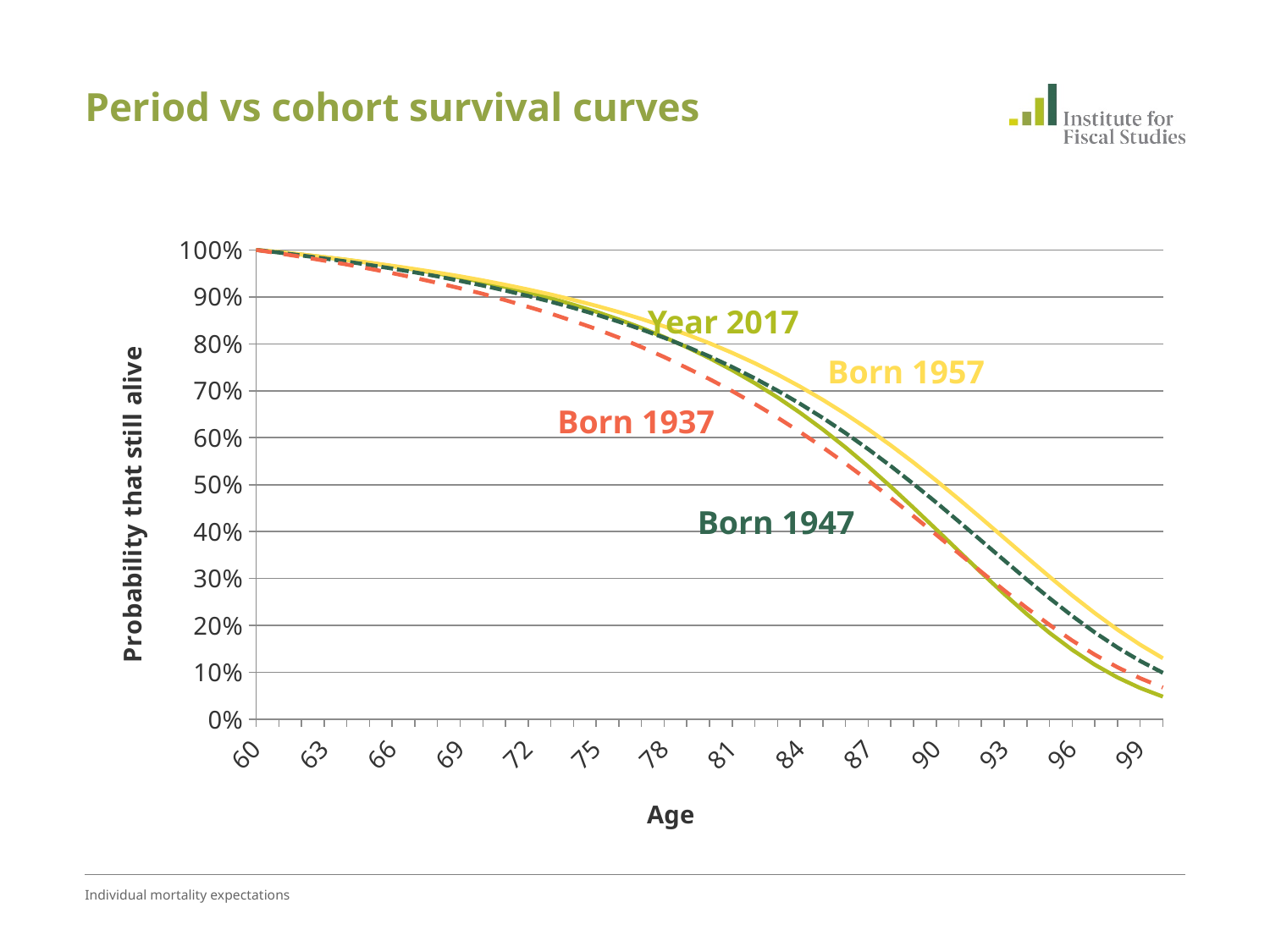
At age 84, which is larger: the Born 1957 curve or the Born 1937 curve? Born 1957 What is the label of the y axis? Probability that still alive Is the value of the Born 1957 curve at age 72 greater or less than 90%? greater What is the probability of still being alive at age 60 for the Born 1957 curve? 100% Which curve is lowest at age 99? Year 2017 What kind of chart is shown on the slide? line chart How many age labels are shown on the x axis? 14 Which curve is highest at age 99? Born 1957 What is the title of the chart on the slide? Period vs cohort survival curves How many series (curves) are plotted on the chart? 4 Do the survival curves rise or fall as age increases along the x axis? fall Is the value of the Year 2017 curve at age 96 greater or less than 20%? less